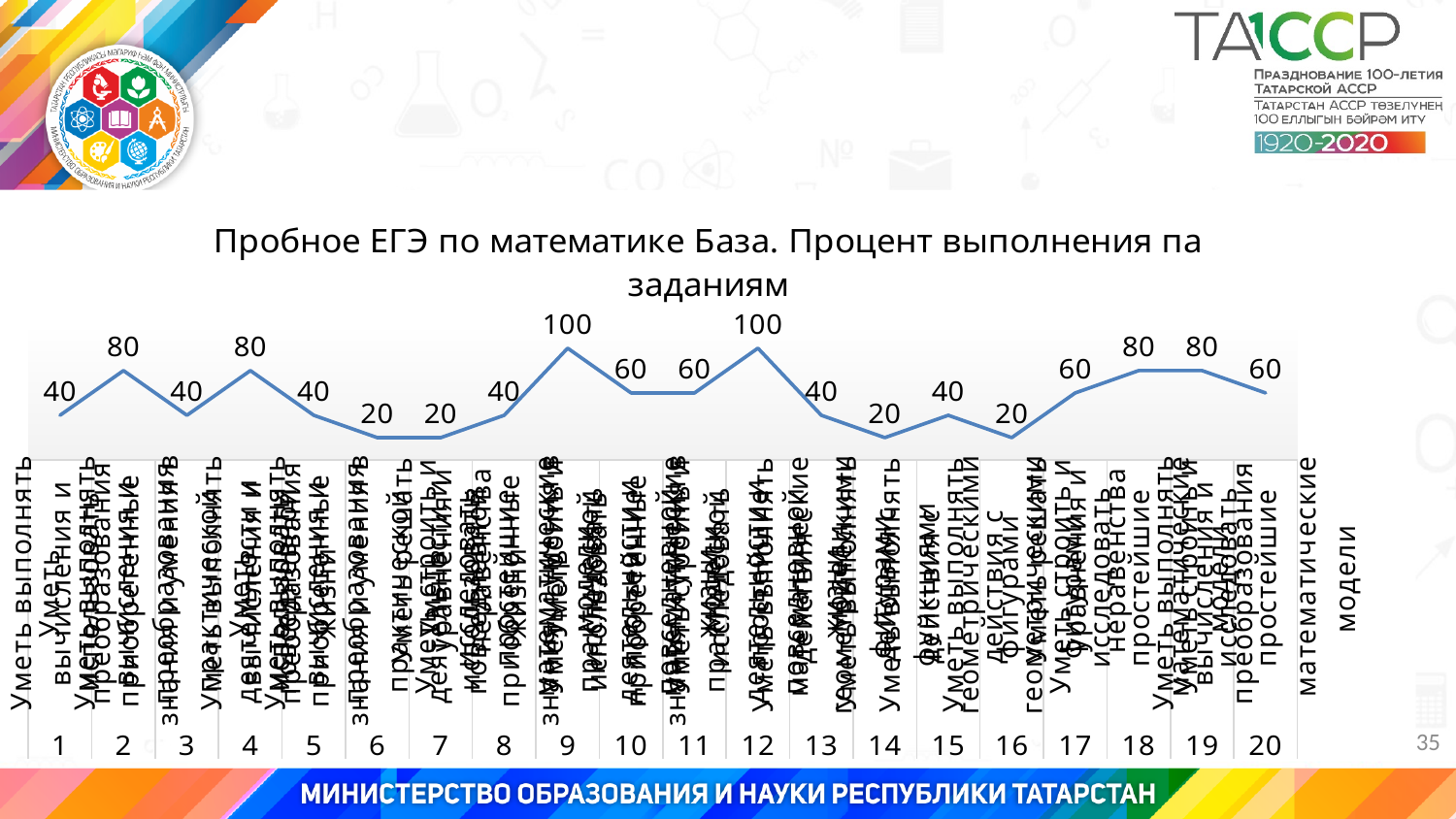
What is the difference between the values for task 12 and task 13? 60 What is the value for task 2? 80 What is the value for task 20? 60 How many tasks are plotted on the chart? 20 Which tasks have the highest value on the chart? 9 and 12 What is the lowest value shown on the chart? 20 Do the values rise or fall from task 16 to task 18? Rise What is the value for task 14? 20 What is the value for task 9? 100 Which has a larger value, task 4 or task 5? Task 4 What kind of chart is shown on the slide? Line chart What is the title of the chart? Пробное ЕГЭ по математике База. Процент выполнения па заданиям